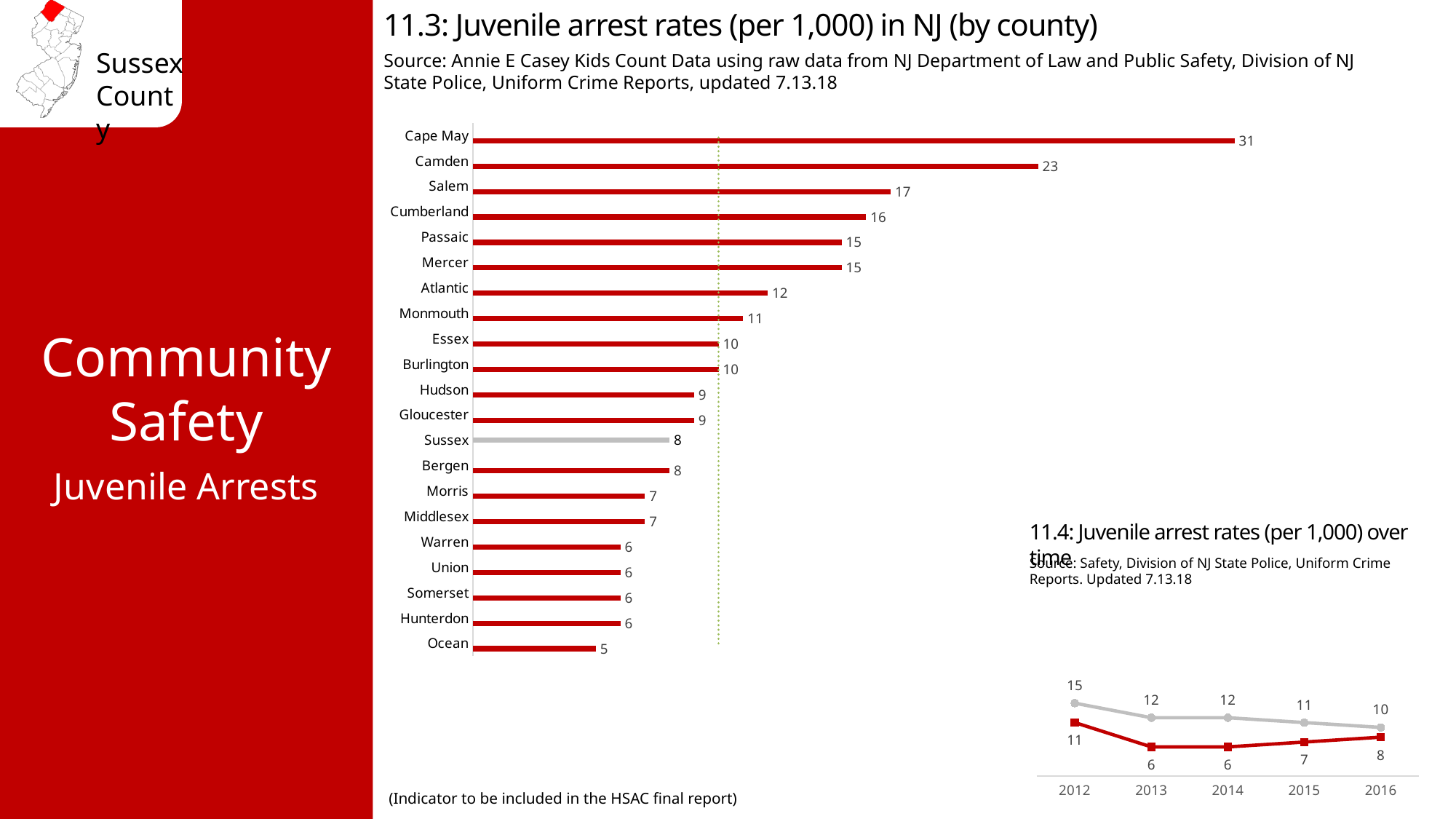
In chart 11.4 (juvenile arrest rates over time), what is the value of the gray line in 2012? 15 In chart 11.3 (juvenile arrest rates by county), what is the difference between the values for Camden and Salem? 6 What type of chart is chart 11.3 (juvenile arrest rates by county)? Bar chart In chart 11.3 (juvenile arrest rates by county), which county's bar is shown in gray instead of red? Sussex In chart 11.4 (juvenile arrest rates over time), does the gray line rise or fall from 2012 to 2016? Fall In chart 11.3 (juvenile arrest rates by county), which county has the highest juvenile arrest rate? Cape May In chart 11.3 (juvenile arrest rates by county), what is the value for Cape May? 31 In chart 11.3 (juvenile arrest rates by county), what is the value for Sussex? 8 In chart 11.3 (juvenile arrest rates by county), how many counties are shown? 21 In chart 11.4 (juvenile arrest rates over time), what is the value of the red line in 2016? 8 In chart 11.3 (juvenile arrest rates by county), which has a higher value, Atlantic or Monmouth? Atlantic In chart 11.3 (juvenile arrest rates by county), which county has the lowest juvenile arrest rate? Ocean